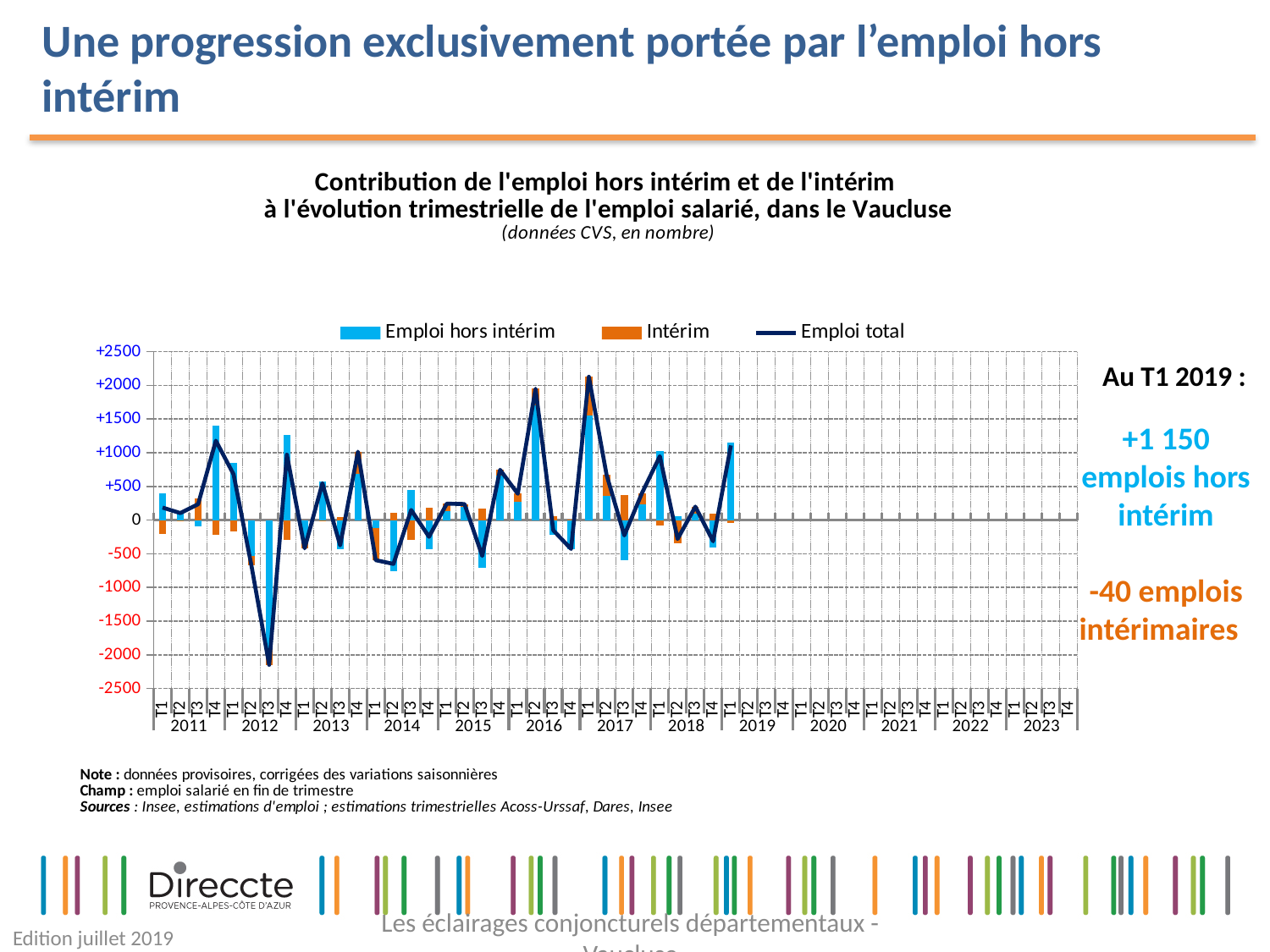
What is the value of Emploi hors intérim at T1 2019? +1 150 In which quarter does the Emploi total line reach its lowest point? T3 2012 Which series is drawn in orange? Intérim Is the value of Emploi hors intérim at T3 2012 greater or less than -1500? less How many years are labelled along the x axis? 13 What are the three series named in the legend? Emploi hors intérim, Intérim, Emploi total Is the value of Emploi total at T3 2012 greater or less than -1500? less Is the value of Emploi total at T1 2017 greater or less than +1500? greater How many series does the legend list? 3 What is the value of Intérim (emplois intérimaires) at T1 2019? -40 What kind of chart is shown on the slide? bar chart with a line Which is larger at T1 2019, Emploi hors intérim or Intérim? Emploi hors intérim